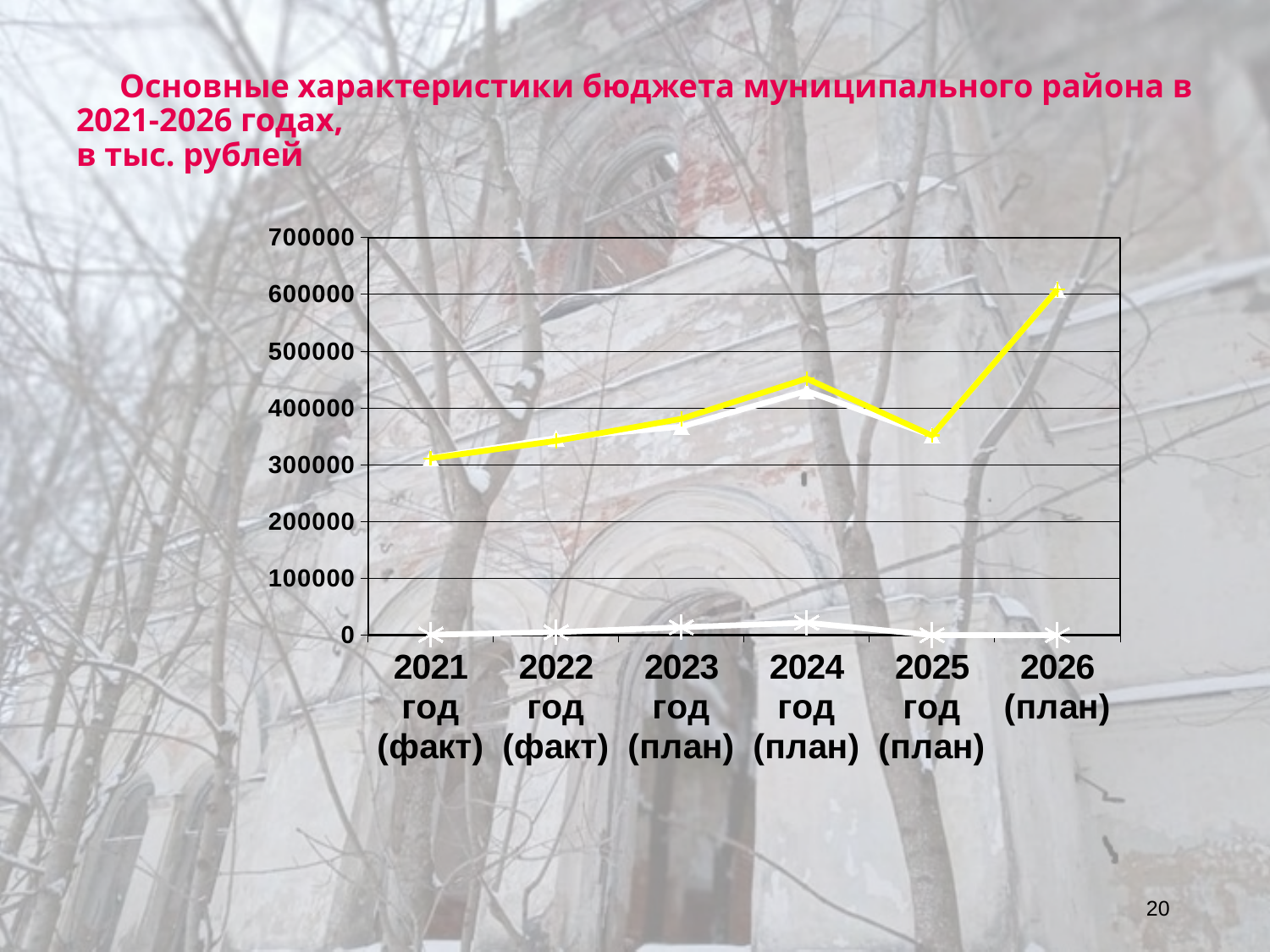
What is the title of the chart on the slide? Основные характеристики бюджета муниципального района в 2021-2026 годах, в тыс. рублей For the yellow line, which year has the larger value: 2024 год (план) or 2025 год (план)? 2024 год (план) Is the value of the yellow line for 2026 (план) greater or less than 500000? greater Is the value of the bottom white line for 2024 год (план) greater or less than 100000? less Is the value of the yellow line for 2025 год (план) greater or less than 400000? less How many years (categories) are shown on the x axis of the chart? 6 In which year does the yellow line reach its highest value? 2026 (план) In which year does the yellow line have its lowest value? 2021 год (факт) What kind of chart is shown on the slide? line chart Does the yellow line rise or fall from 2021 год (факт) to 2024 год (план)? rise How many lines are plotted on the chart? 3